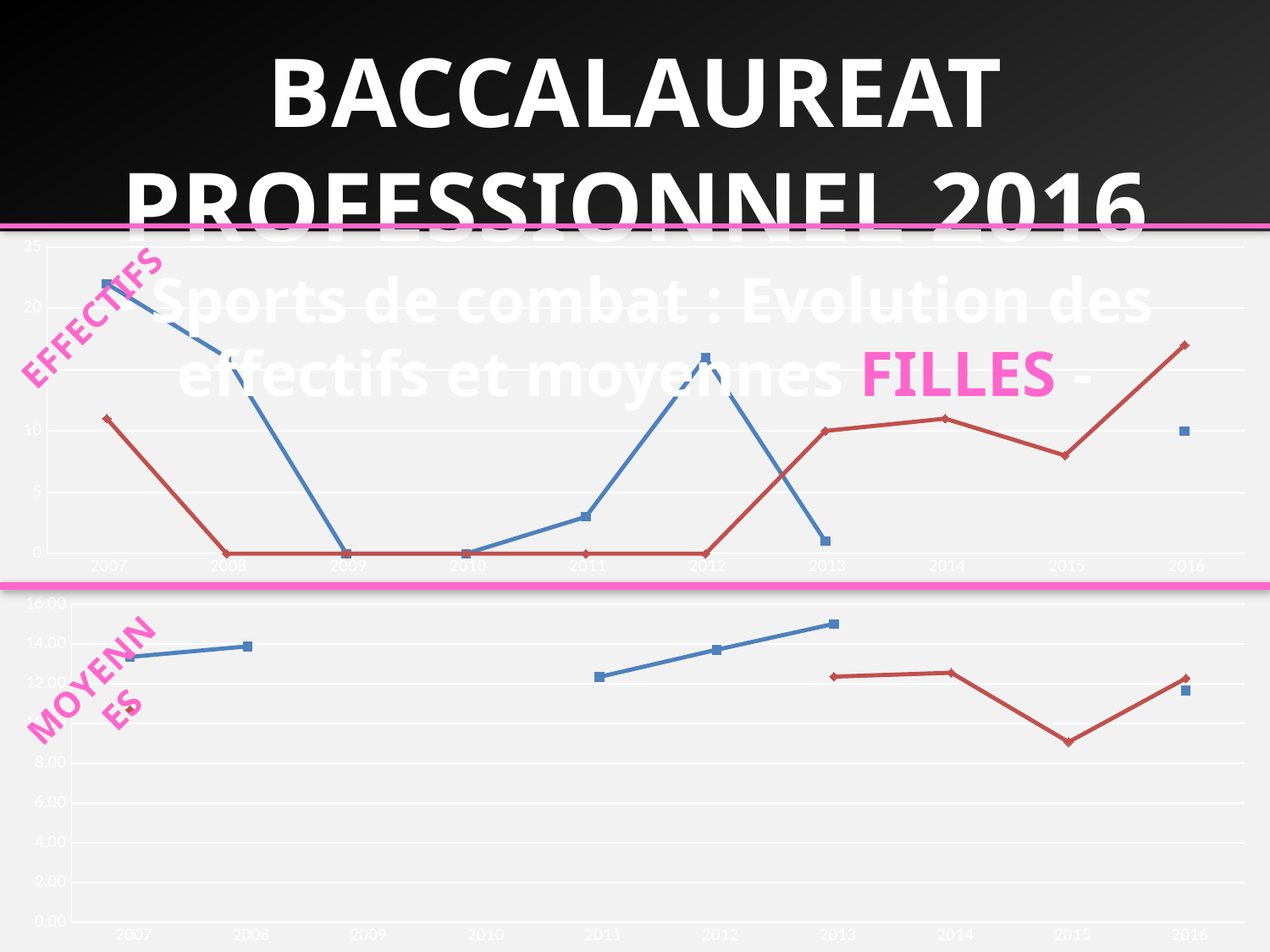
In the top chart (EFFECTIFS), in which year does the blue line reach its highest value? 2007 What kind of chart is the top chart labelled EFFECTIFS? line chart In the bottom chart (MOYENNES), is the value of the blue line in 2013 greater or less than 14.00? greater In the top chart (EFFECTIFS), is the value of the blue line in 2007 greater or less than 20? greater In the bottom chart (MOYENNES), is the value of the red line in 2015 greater or less than 10.00? less In the top chart (EFFECTIFS), how many years are shown on the x axis? 10 In the bottom chart (MOYENNES), does the blue line rise or fall from 2011 to 2013? rise In the top chart (EFFECTIFS), what is the value of the red line in 2010? 0 In the top chart (EFFECTIFS), in 2013, which line has the larger value, the blue or the red? red In the top chart (EFFECTIFS), what is the value of the blue line in 2009? 0 In the bottom chart (MOYENNES), in which year does the red line reach its lowest value? 2015